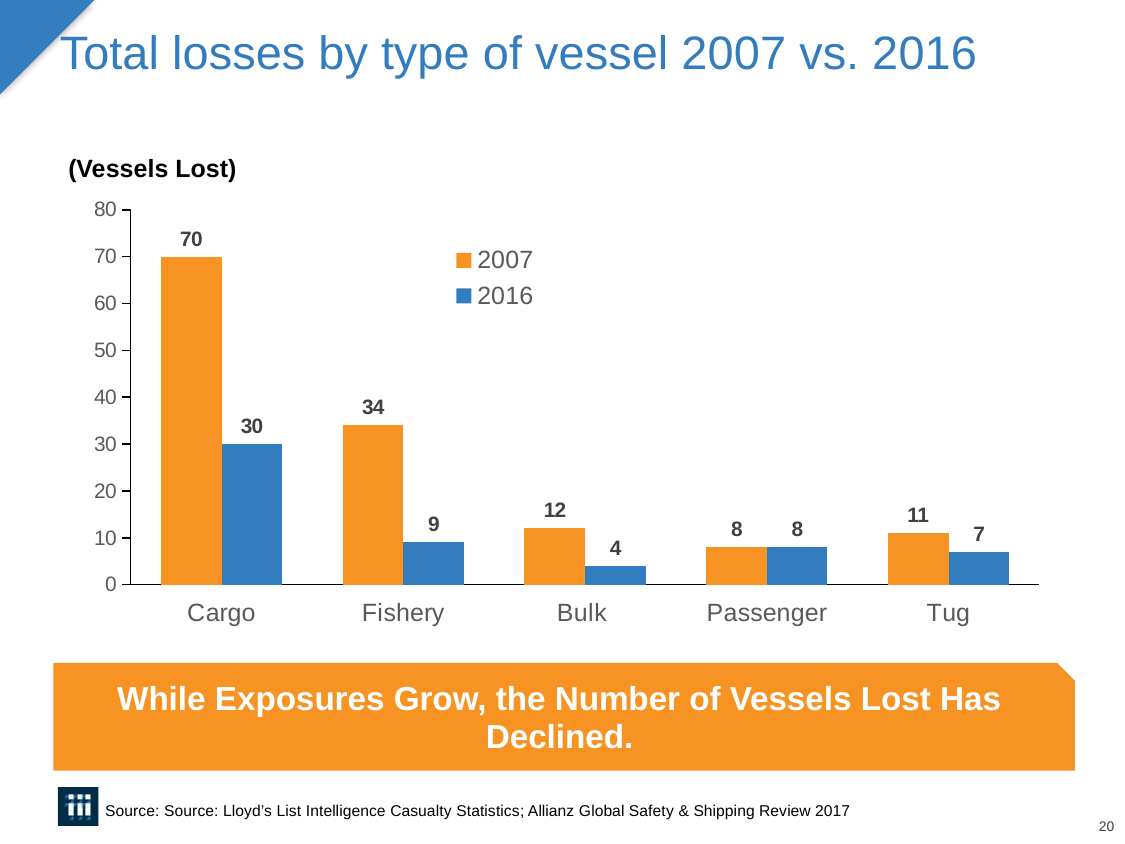
What is the value for Fishery in 2016? 9 How many vessels were lost in the Cargo category in 2007? 70 How many series does the legend list? 2 Which vessel type had the highest number of losses in 2007? Cargo Which vessel type had the lowest number of losses in 2016? Bulk What is the difference between the 2007 and 2016 values for Fishery? 25 Which colour represents the 2016 series in the chart? Blue How many vessel types are shown on the x axis? 5 What is the value for Tug in 2007? 11 What kind of chart is shown on the slide? Bar chart What is the difference between the 2007 and 2016 values for Cargo? 40 Which is larger, the 2007 value for Bulk or the 2016 value for Bulk? 2007